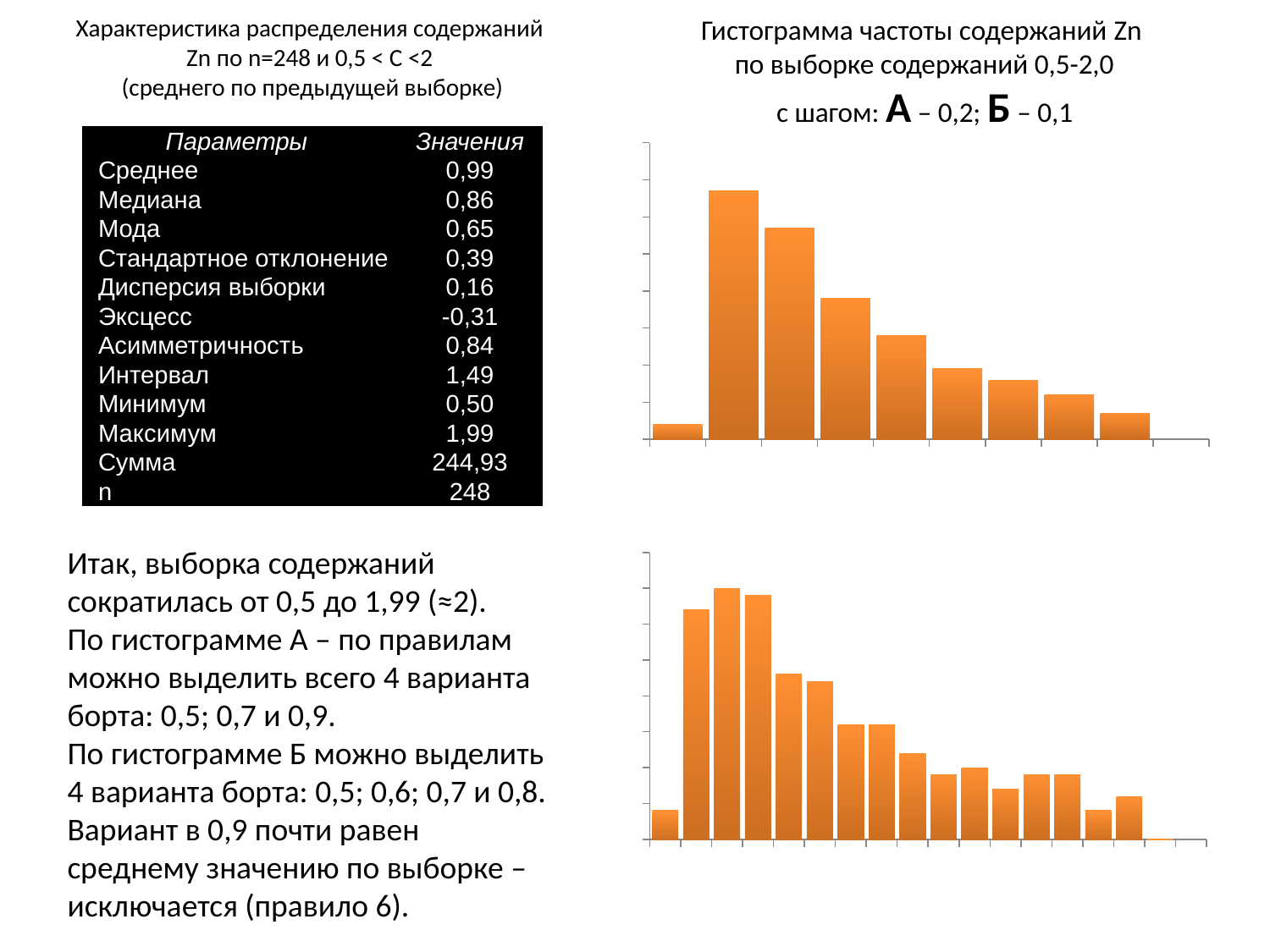
In the bottom chart (histogram Б), is the leftmost bar taller or shorter than the second bar from the left? shorter In the bottom chart (histogram Б), do the bar heights generally rise or fall from the peak toward the right end of the axis? fall What colour are the bars in both histograms? orange What kind of chart is the bottom chart on the right side of the slide? bar chart In the top chart (histogram А), which is taller: the second bar from the left or the third bar from the left? the second bar from the left In the top chart (histogram А), which bar is the shortest? the first (leftmost) bar According to the chart title, what step (шаг) is used for histogram А? 0,2 In the bottom chart (histogram Б), which bar is the tallest? the third bar from the left In the top chart (histogram А), do the bars rise or fall from the second bar to the rightmost bar? fall In the top chart (histogram А), how many bars are plotted? 9 In the top chart (histogram А), which bar is the tallest? the second bar from the left What kind of chart is the top chart on the right side of the slide? bar chart